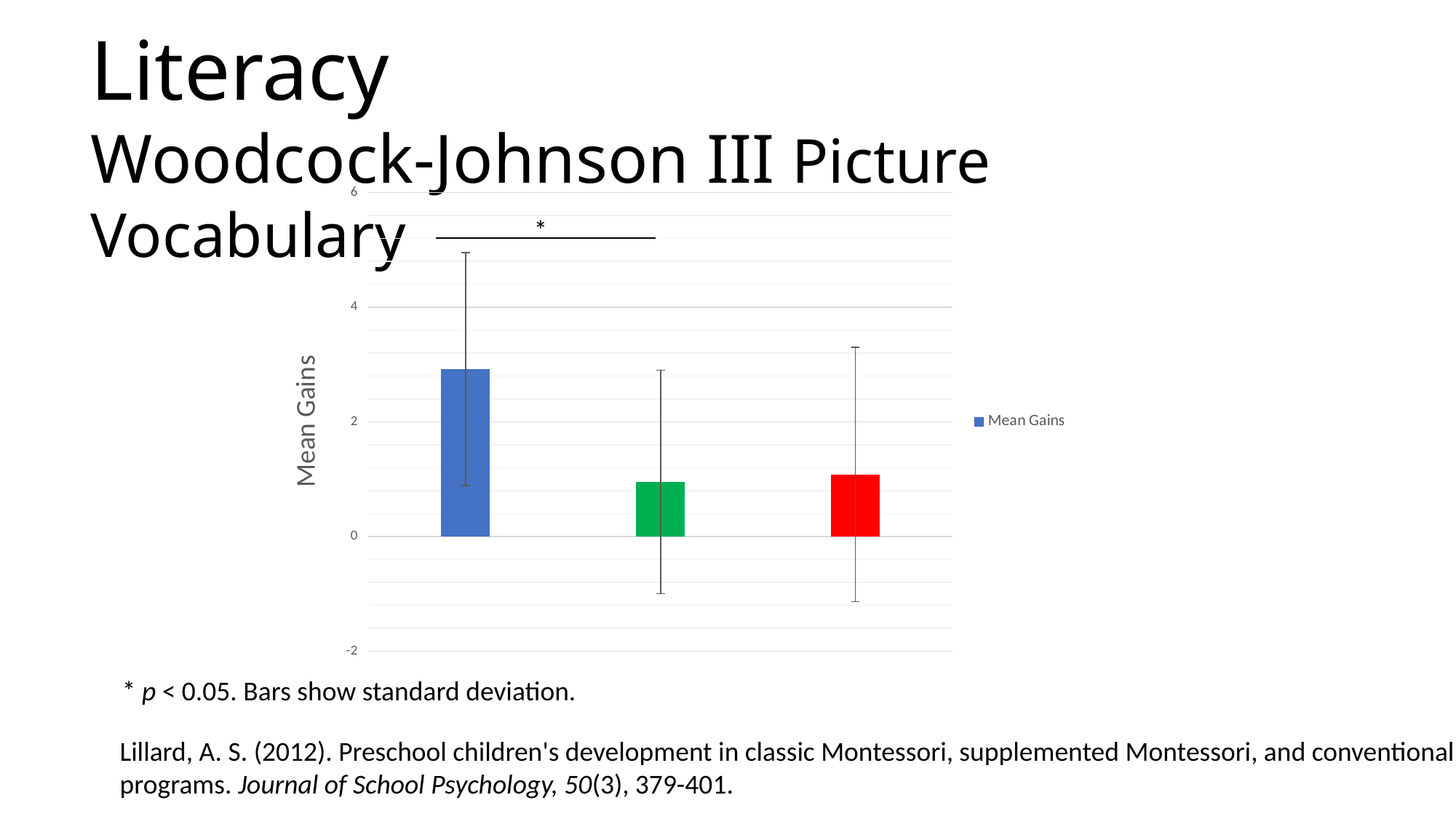
Is the value for the first (blue) bar greater or less than 2? greater What kind of chart is shown on the slide? bar chart Which bar shows the highest mean gain? the first (blue) bar What is the label on the vertical axis of the chart? Mean Gains What series name appears in the chart legend? Mean Gains Which is larger, the value of the first (blue) bar or the second (green) bar? the first (blue) bar How many series does the legend list? 1 Is the value for the second (green) bar greater or less than 2? less How many bars are plotted in the chart? 3 Is the value for the first (blue) bar greater or less than 4? less Which is larger, the value of the first (blue) bar or the third (red) bar? the first (blue) bar